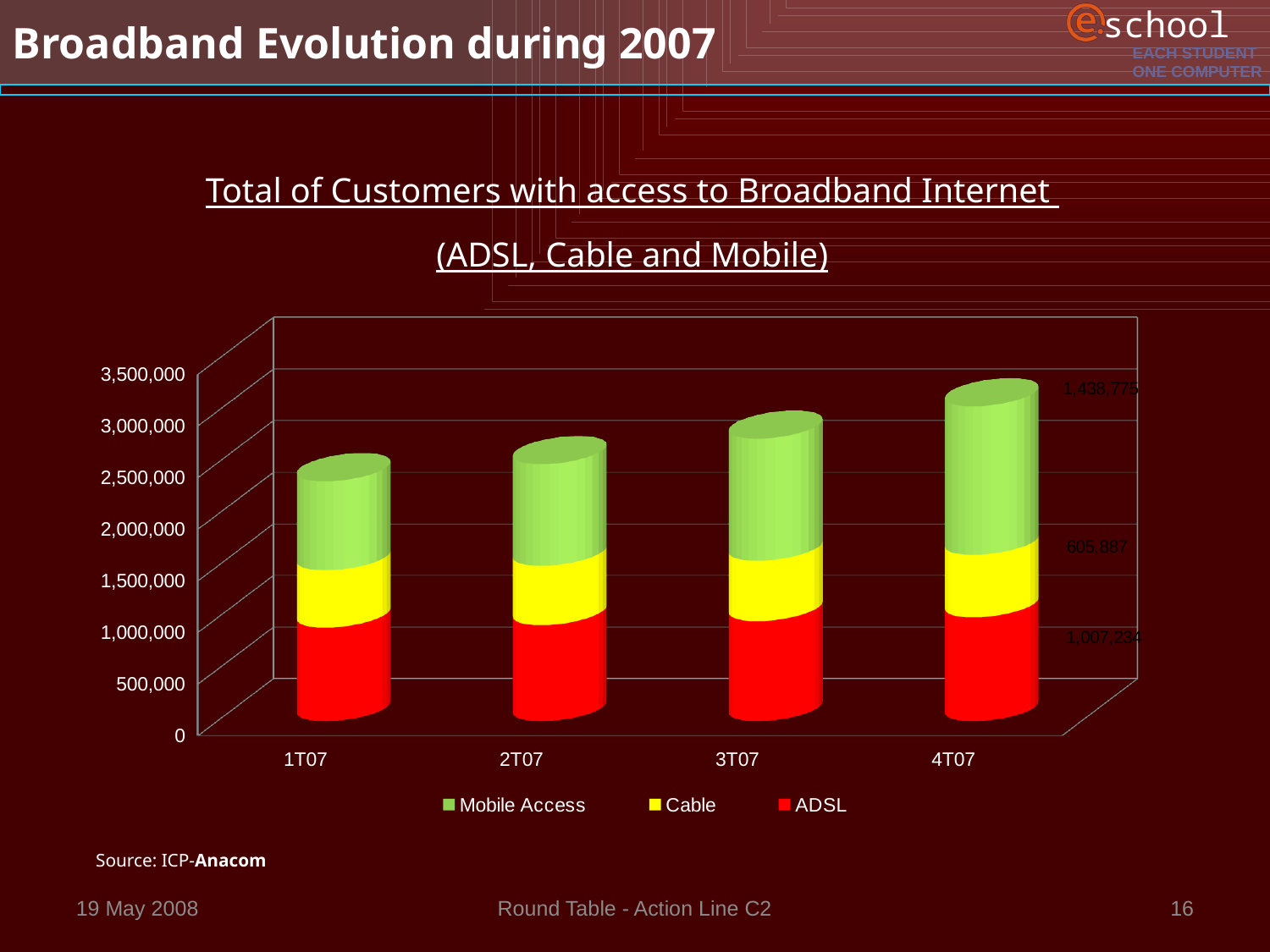
What is the total of the stacked bar for 4T07? 3,051,896 What is the value for Cable in 4T07? 605,887 In 4T07, which is larger: Mobile Access or Cable? Mobile Access What is the value for ADSL in 4T07? 1,007,234 Which series has the smallest value in 4T07? Cable How many series does the chart legend list? 3 Do the total bar heights rise or fall from 1T07 to 4T07? Rise What is the difference between Mobile Access and ADSL in 4T07? 431,541 How many quarters are shown on the x axis of the chart? 4 What kind of chart is shown on the slide? Stacked bar chart What is the value for Mobile Access in 4T07? 1,438,775 Which quarter has the highest total bar? 4T07